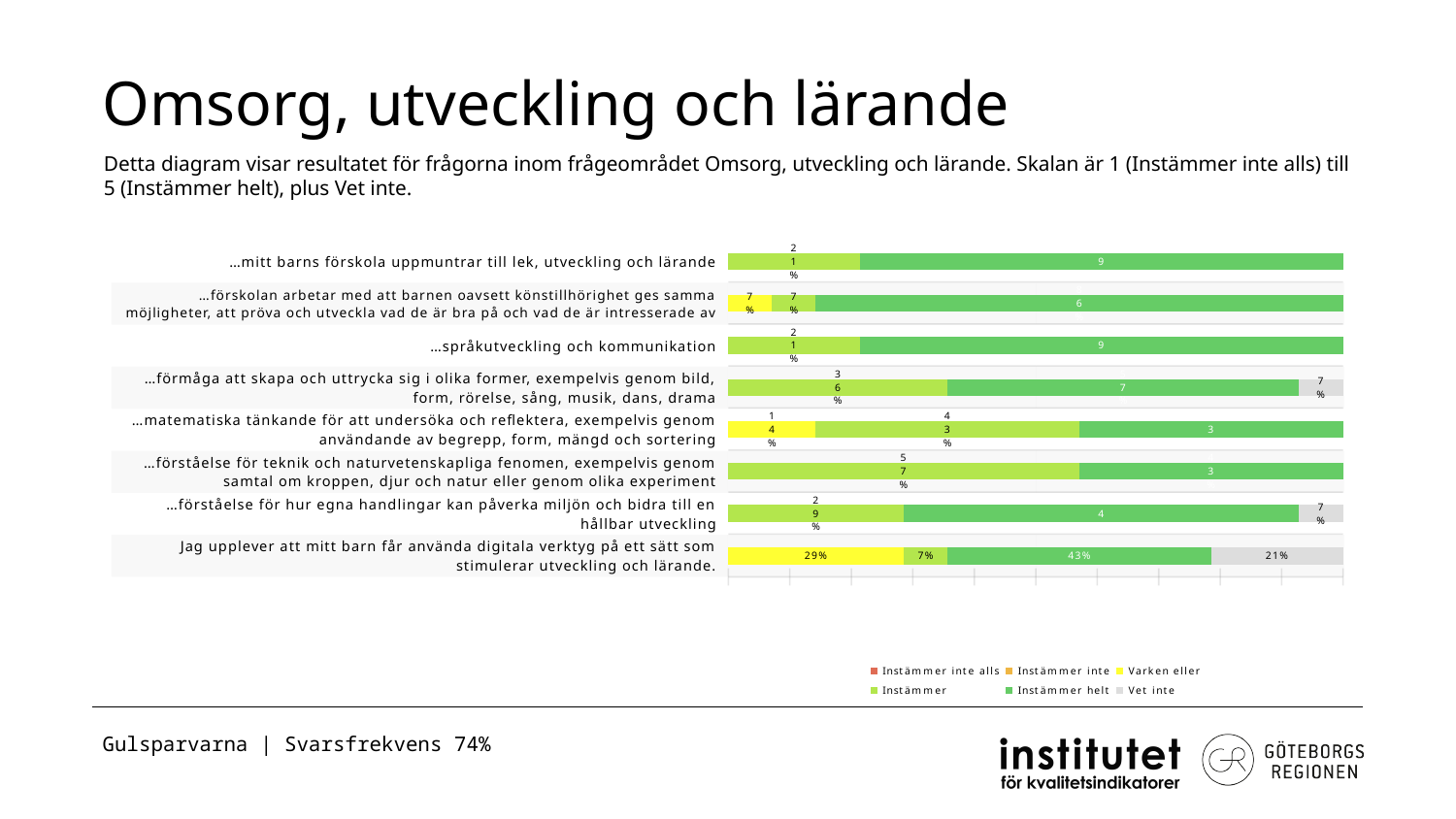
Which colour represents 'Varken eller' in the legend? Yellow What is the 'Varken eller' value for 'Jag upplever att mitt barn får använda digitala verktyg på ett sätt som stimulerar utveckling och lärande.'? 29% What kind of chart is shown on the slide? Stacked bar chart What is the 'Instämmer' value for '…förståelse för teknik och naturvetenskapliga fenomen, exempelvis genom samtal om kroppen, djur och natur eller genom olika experiment'? 57% For 'Jag upplever att mitt barn får använda digitala verktyg…', which is larger: the 'Varken eller' share or the 'Instämmer' share? Varken eller How many series does the legend list? 6 What is the 'Vet inte' value for 'Jag upplever att mitt barn får använda digitala verktyg på ett sätt som stimulerar utveckling och lärande.'? 21% What is the 'Instämmer helt' value for 'Jag upplever att mitt barn får använda digitala verktyg på ett sätt som stimulerar utveckling och lärande.'? 43% How many question categories (bars) does the chart show? 8 Which category has the largest 'Vet inte' share? Jag upplever att mitt barn får använda digitala verktyg på ett sätt som stimulerar utveckling och lärande. For 'Jag upplever att mitt barn får använda digitala verktyg…', what is the difference between the 'Instämmer helt' share and the 'Vet inte' share? 22 percentage points What is the 'Vet inte' value for '…förståelse för hur egna handlingar kan påverka miljön och bidra till en hållbar utveckling'? 7%